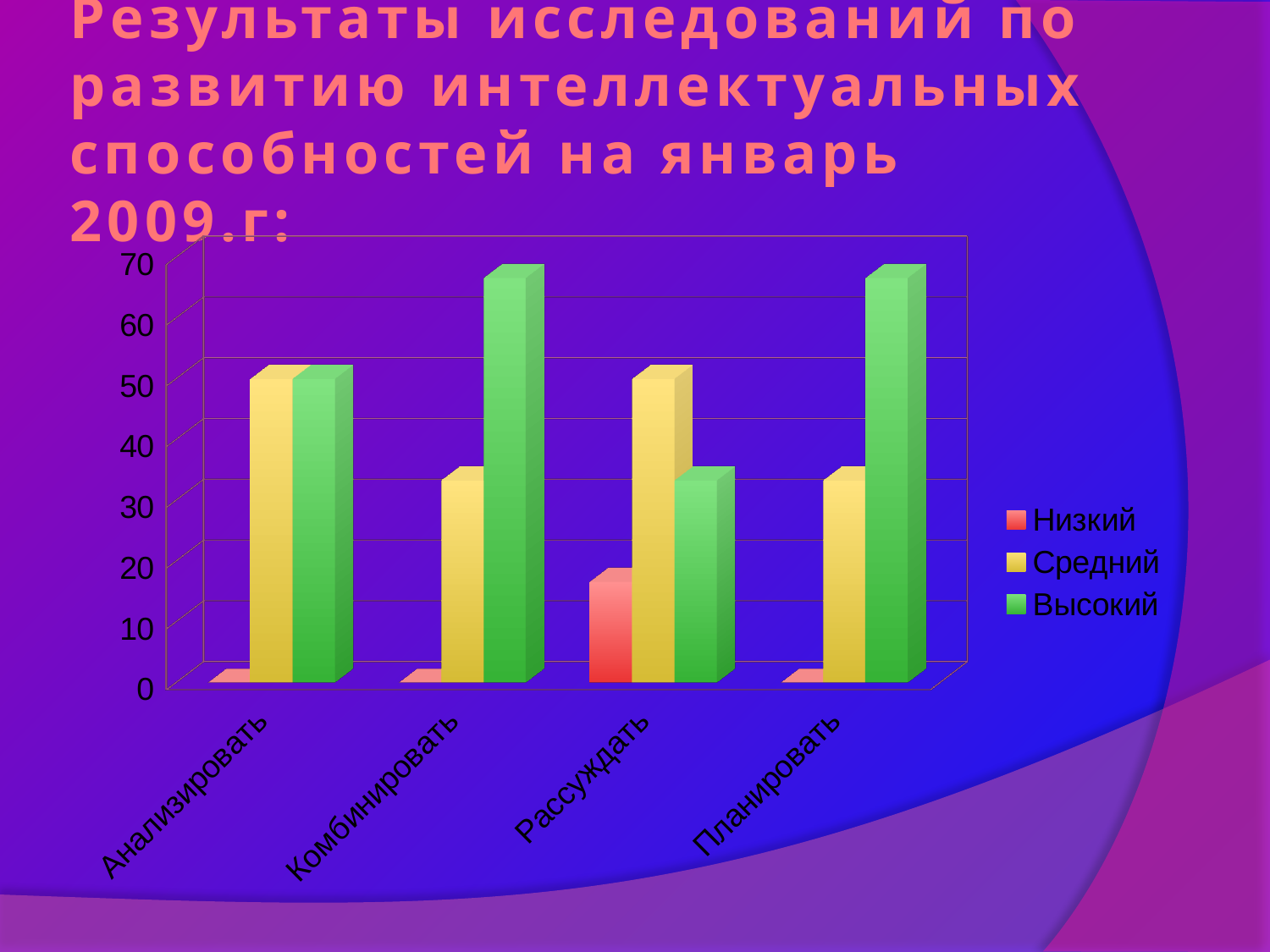
For Рассуждать, which is larger: Средний or Высокий? Средний What are the three legend entries of the chart? Низкий, Средний, Высокий Is the value of Средний for Планировать greater or less than 40? less For Комбинировать, which is larger: Средний or Высокий? Высокий How many series does the legend list? 3 What kind of chart is shown on the slide? bar chart How many categories are shown on the x axis? 4 Is the value of Низкий for Рассуждать greater or less than 30? less Which category has the highest value for Низкий? Рассуждать Which is larger: Высокий for Планировать or Высокий for Рассуждать? Планировать Is the value of Высокий for Комбинировать greater or less than 60? greater Which series has the lowest value for Анализировать? Низкий